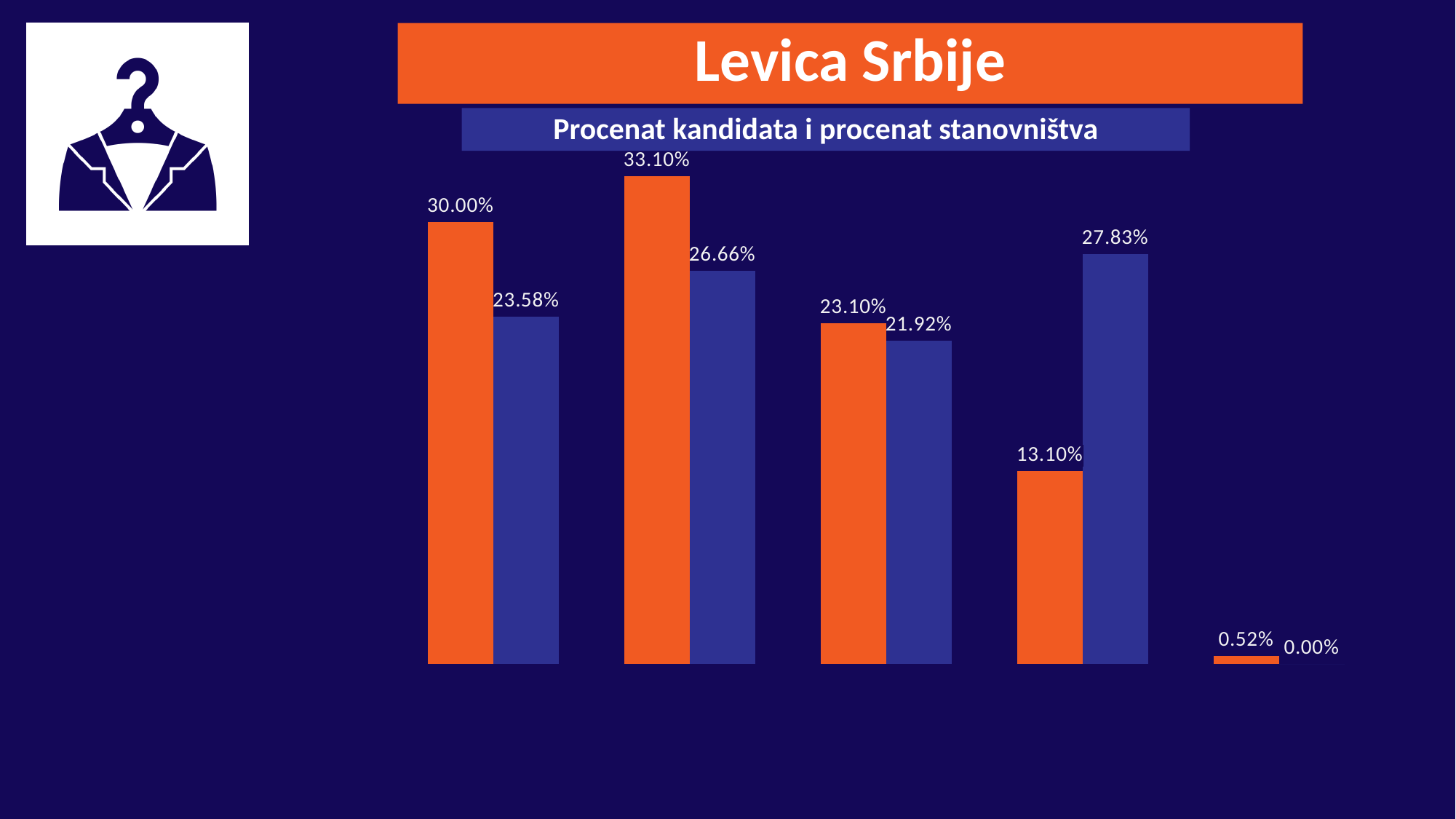
Which orange bar has the highest value? the second group (33.10%) What is the difference between the orange bar (30.00%) and the blue bar (23.58%) in the first group? 6.42% Which blue bar has the highest value? the fourth group (27.83%) What kind of chart is shown on the slide? bar chart What is the value of the orange bar in the first (leftmost) group? 30.00% What is the value of the orange bar in the fourth group? 13.10% How many groups of bars are plotted in the chart? 5 What is the difference between the blue bar (27.83%) and the orange bar (13.10%) in the fourth group? 14.73% In the fourth group, which bar is larger, the orange bar or the blue bar? the blue bar What is the value of the blue bar in the fifth (rightmost) group? 0.00% What is the title of the chart? Procenat kandidata i procenat stanovništva What is the value of the blue bar in the second group? 26.66%